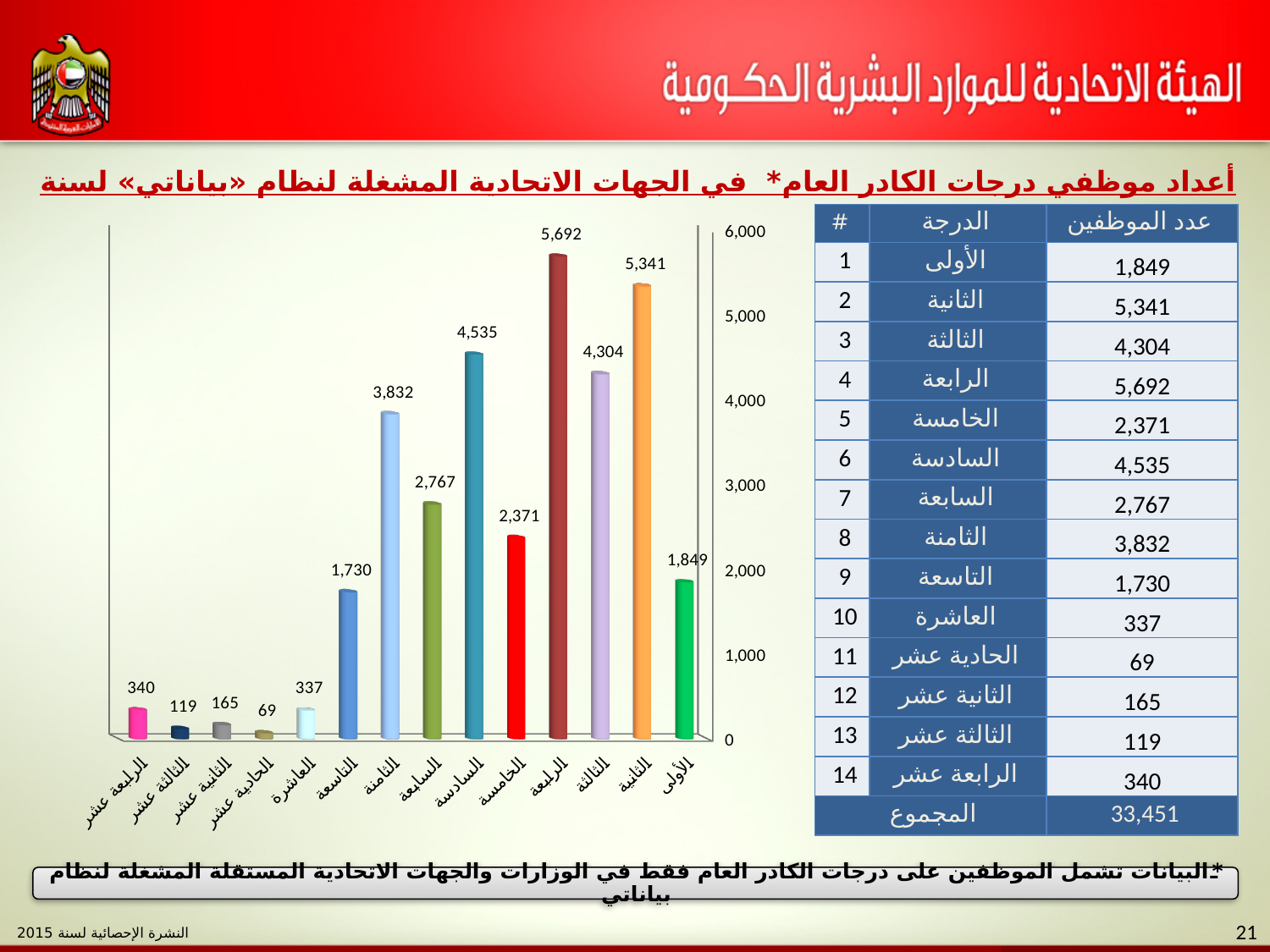
What is the highest value shown on the vertical axis of the bar chart? 6,000 What is the difference between the values for الثانية and الأولى in the bar chart? 3,492 What is the value for الثامنة (the eighth grade) in the bar chart? 3,832 What kind of chart is shown on the slide? bar chart Is the value for الخامسة in the bar chart greater or less than 2,000? greater What is the total number of employees shown in the table (المجموع)? 33,451 What is the value for الحادية عشر (the eleventh grade) in the bar chart? 69 What is the value for الرابعة (the fourth grade) in the bar chart? 5,692 Which grade has the lowest number of employees in the bar chart? الحادية عشر Which is larger in the bar chart, the value for السادسة or the value for الثالثة? السادسة How many grade categories are shown in the bar chart? 14 Which grade has the highest number of employees in the bar chart? الرابعة